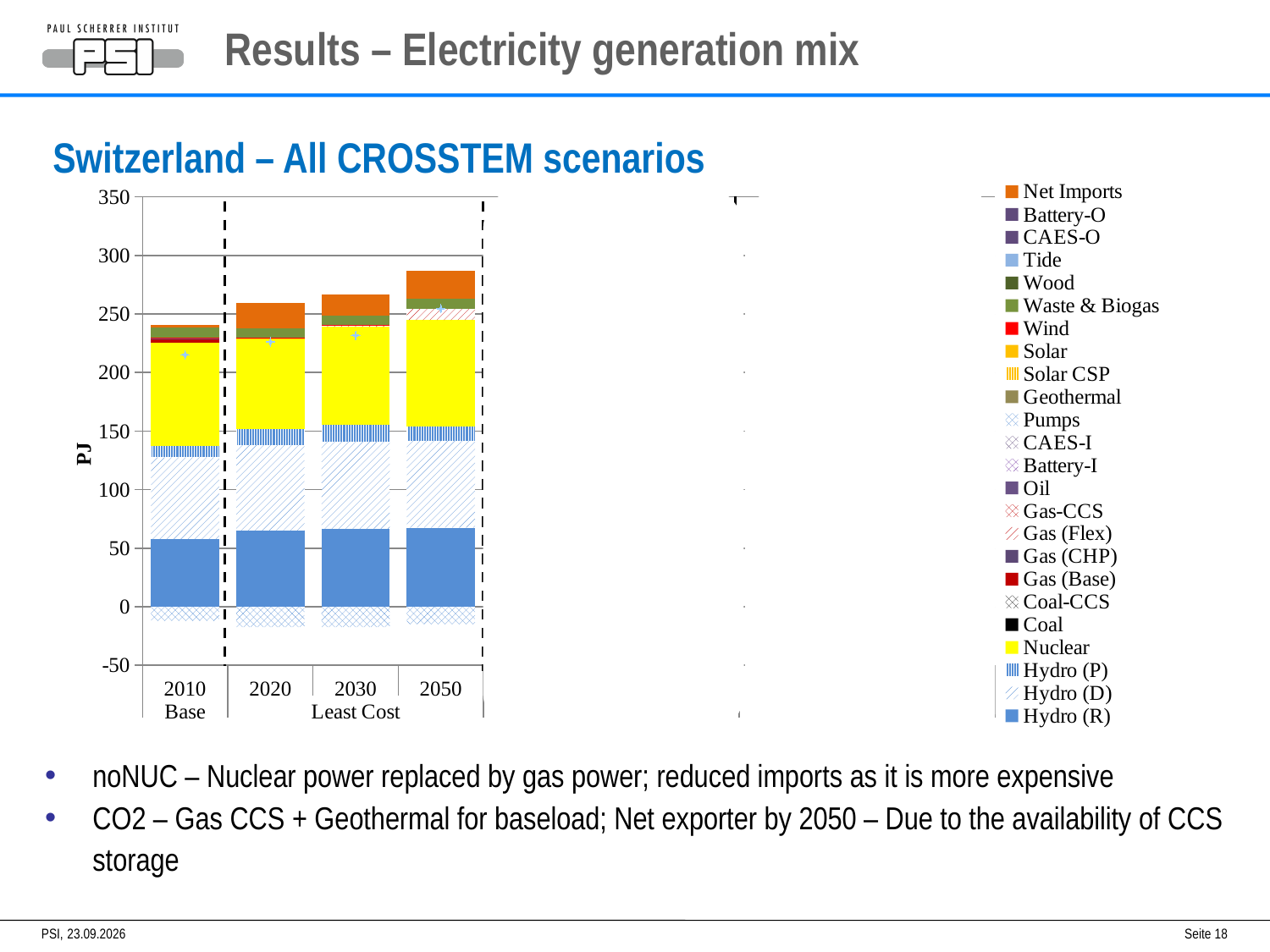
Which scenario label is shown beneath the 2020, 2030 and 2050 bars? Least Cost What is the label on the y axis of the chart? PJ Is the Hydro (R) value for 2010 greater or less than 50 PJ? greater Which year has the tallest stacked bar in the chart? 2050 Is the top of the stacked bar for 2010 greater or less than 250 PJ? less Is the top of the stacked bar for 2050 greater or less than 250 PJ? greater What kind of chart is shown on the slide? Stacked bar chart Does the total height of the stacked bars rise or fall from 2010 to 2050? Rise How many series does the chart's legend list? 24 Which year has the shortest stacked bar in the chart? 2010 How many year categories are shown on the x axis of the chart? 4